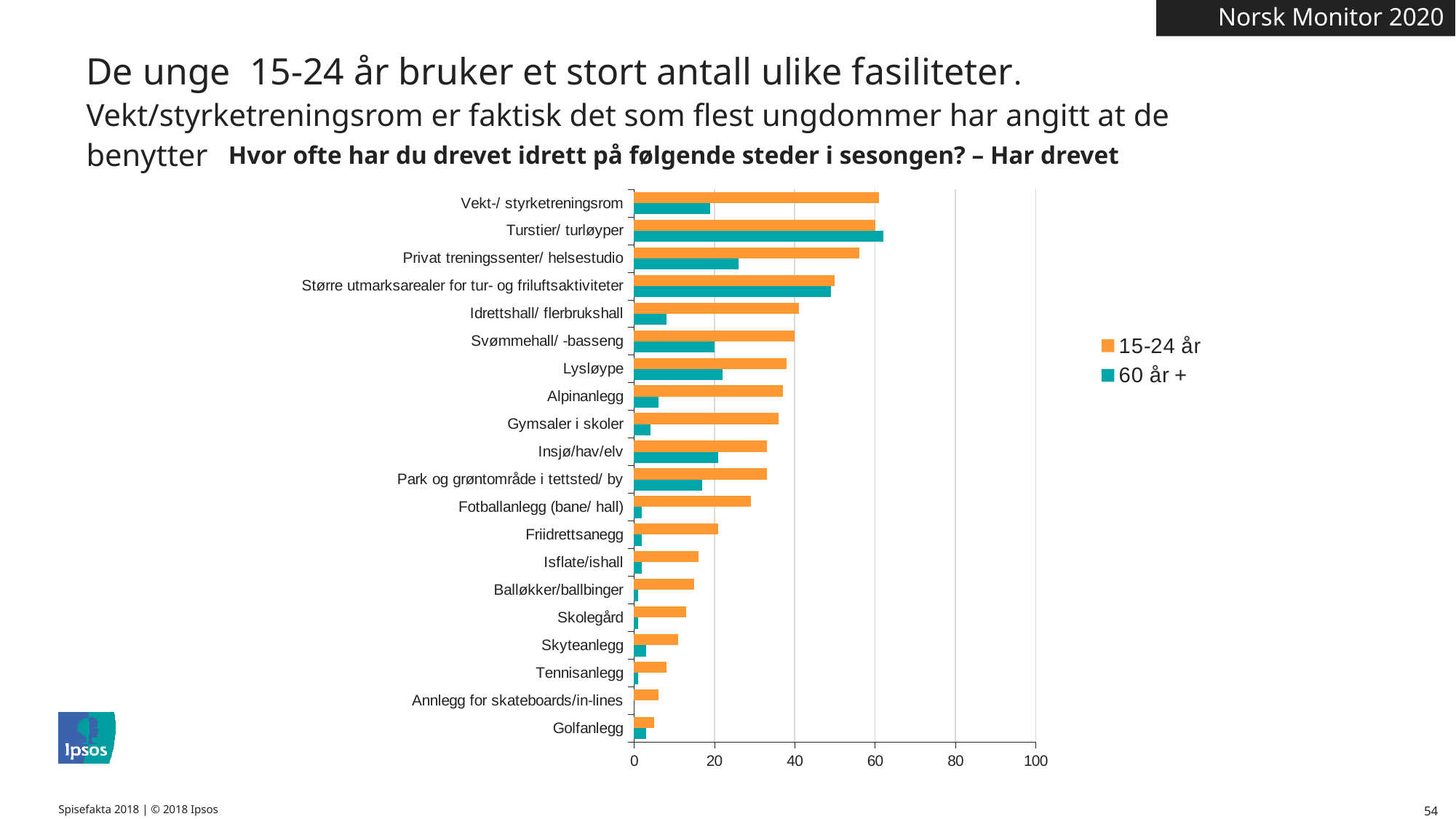
How many series does the legend list? 2 In the 15-24 år series, which is larger: Lysløype or Skolegård? Lysløype Is the value for Fotballanlegg (bane/ hall) in the 60 år + series greater or less than 20? less Which colour represents the 60 år + series in the chart? teal How many categories (facilities) are plotted on the chart? 20 Is the value for Privat treningssenter/ helsestudio in the 60 år + series greater or less than 20? greater Is the value for Vekt-/ styrketreningsrom in the 15-24 år series greater or less than 40? greater What kind of chart is shown on the slide? bar chart For Idrettshall/ flerbrukshall, which series has the larger value, 15-24 år or 60 år +? 15-24 år Which category has the highest value for the 60 år + series? Turstier/ turløyper